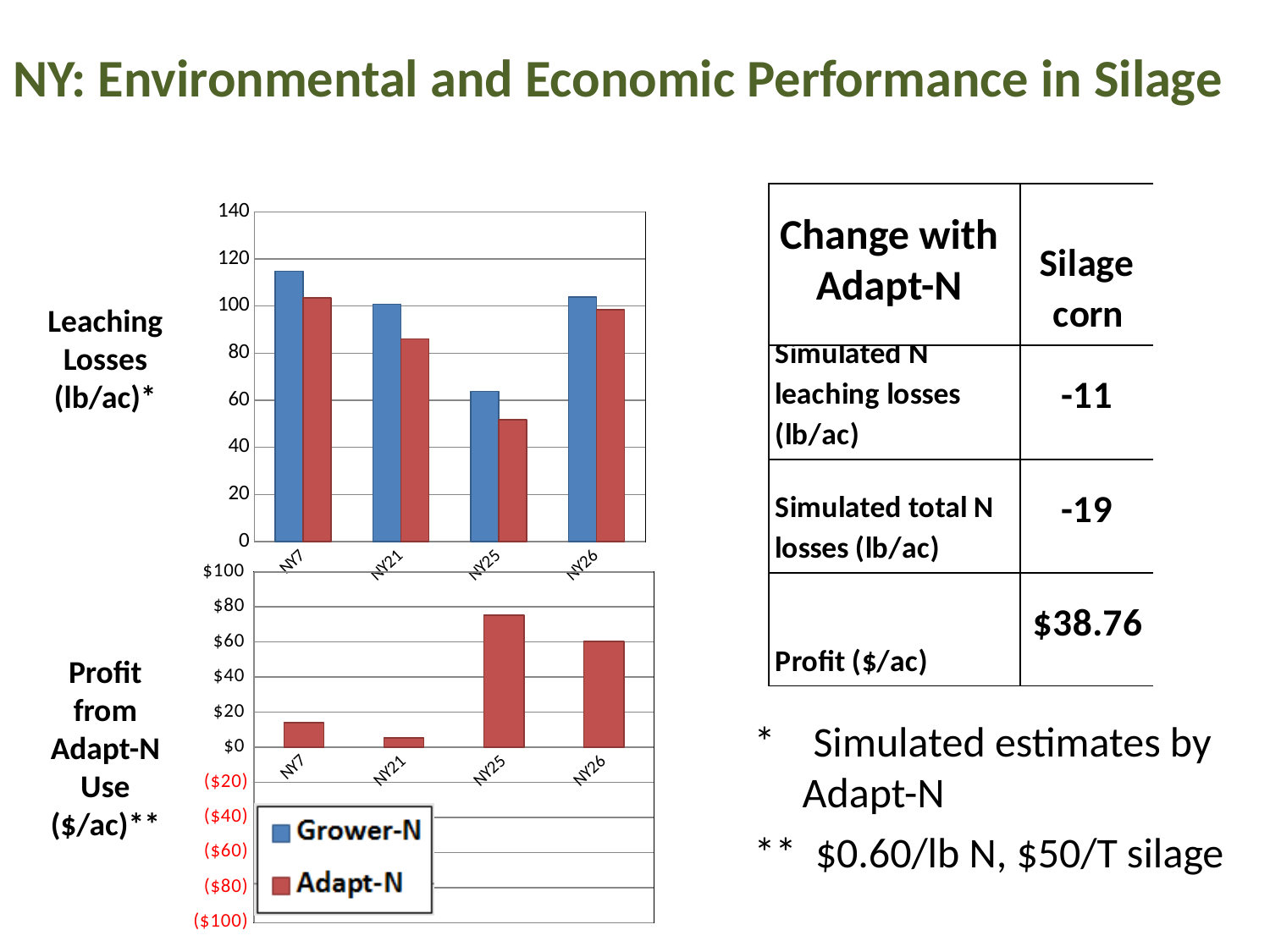
In the bottom chart (Profit from Adapt-N Use), which site has the highest profit? NY25 Which colour represents the Adapt-N series in the legend? red In the top chart (Leaching Losses), which site has the lowest Adapt-N leaching loss? NY25 What kind of chart is the top chart (Leaching Losses)? bar chart In the top chart (Leaching Losses), is the Grower-N value for NY7 greater or less than 100? greater How many site categories are shown on the x axis of the top chart (Leaching Losses)? 4 In the top chart (Leaching Losses), which is larger at NY21: the Grower-N value or the Adapt-N value? Grower-N How many series does the legend list? 2 In the bottom chart (Profit from Adapt-N Use), is the value for NY26 greater or less than $40? greater In the bottom chart (Profit from Adapt-N Use), which site has the lowest profit? NY21 In the top chart (Leaching Losses), is the Adapt-N value for NY25 greater or less than 60? less In the top chart (Leaching Losses), which site has the highest Grower-N leaching loss? NY7